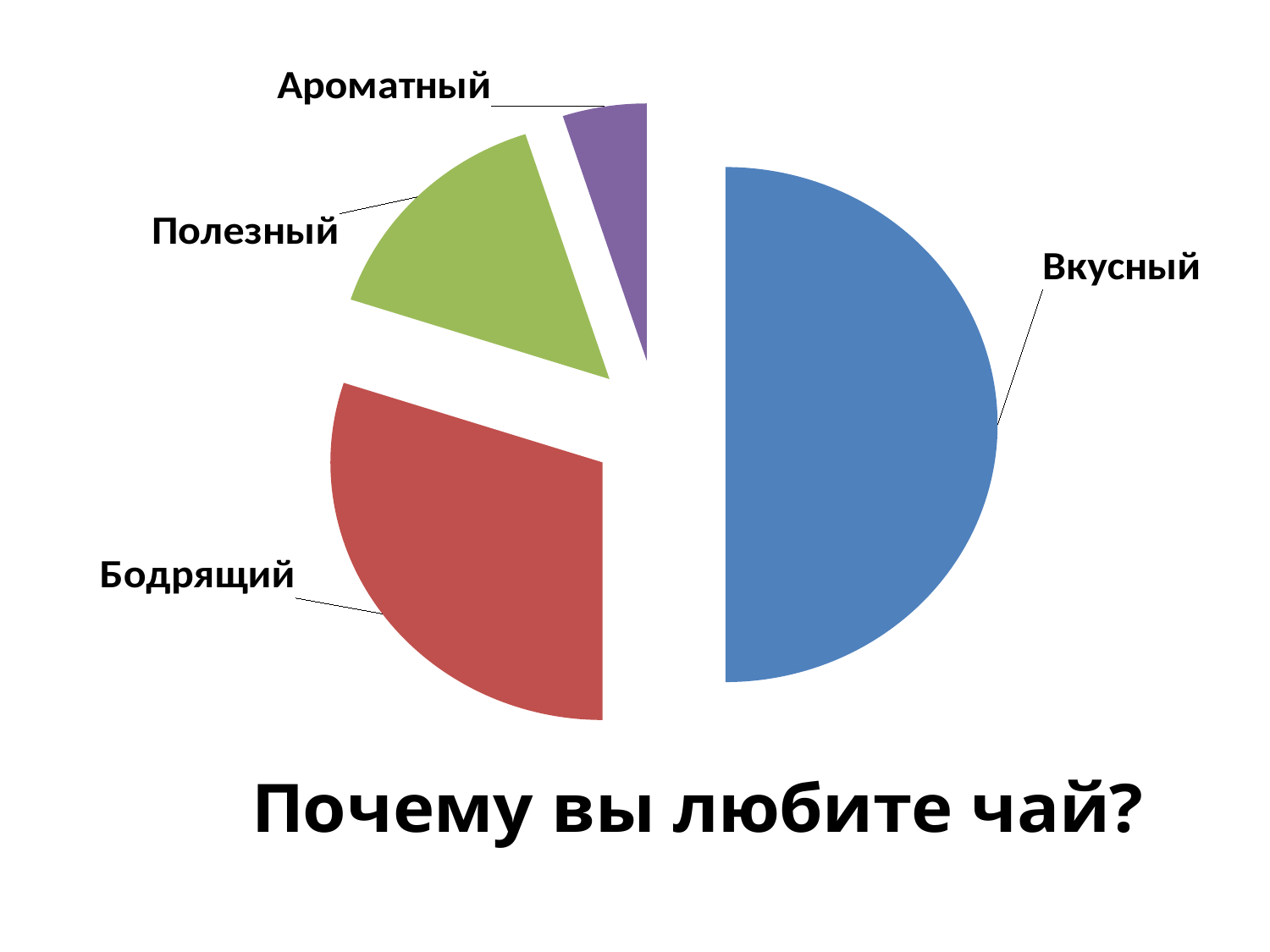
Which category has the smallest slice of the pie? Ароматный Which category has the largest slice of the pie? Вкусный What is the title shown below the pie chart? Почему вы любите чай? Which slice is larger, Полезный or Ароматный? Полезный Which slice is larger, Вкусный or Бодрящий? Вкусный Which slice is larger, Бодрящий or Полезный? Бодрящий How many slices does the pie chart have? 4 What colour is the slice labelled Вкусный? blue What kind of chart is shown on the slide? pie chart